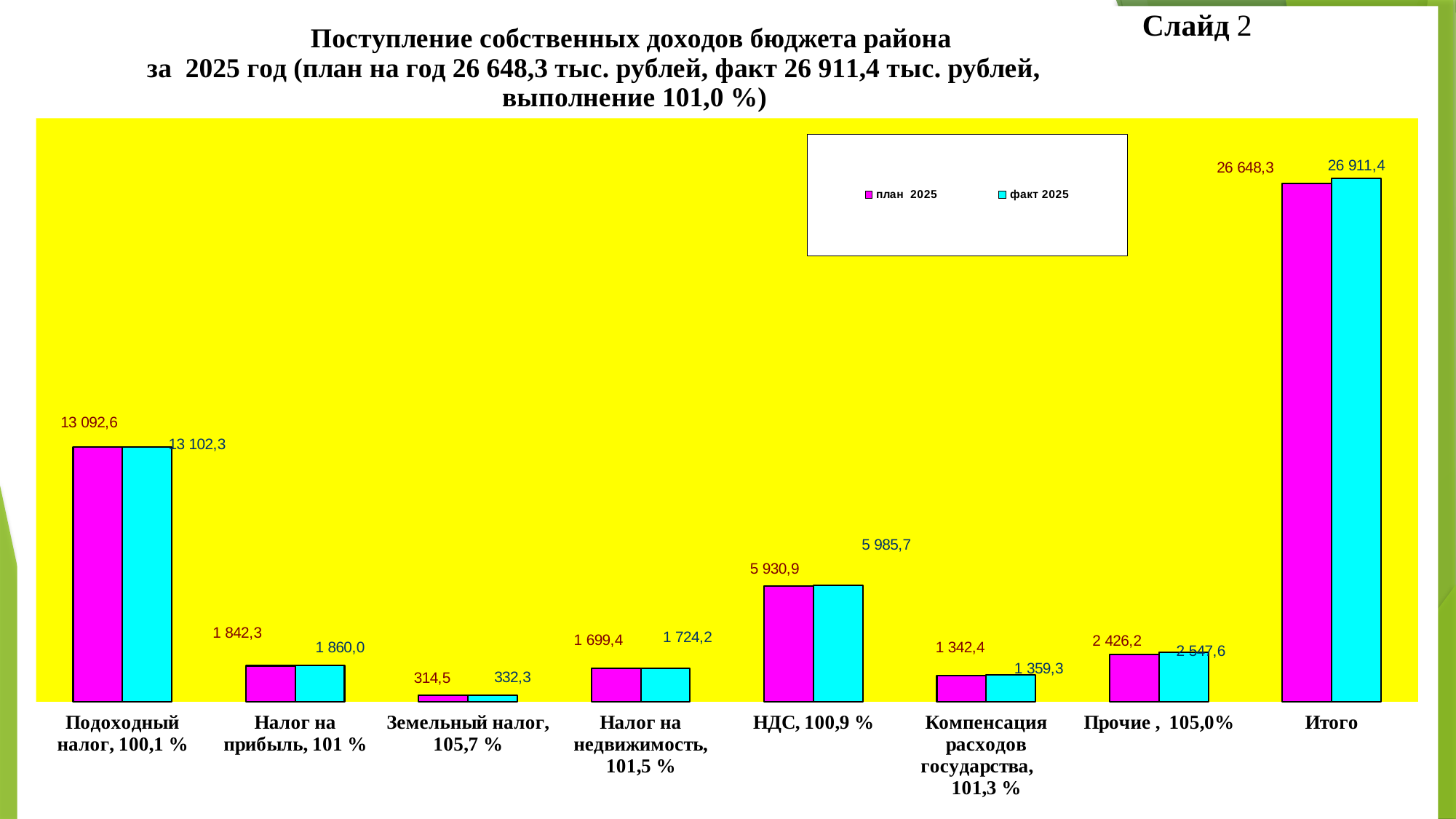
What type of chart is shown on the slide? Bar chart What is the difference between the факт 2025 and план 2025 values for Прочие? 121,4 How many categories are shown on the x axis of the chart? 8 What is the план 2025 value for Компенсация расходов государства? 1 342,4 How many series does the legend list? 2 What is the факт 2025 value for Земельный налог? 332,3 Which category has the lowest план 2025 value? Земельный налог Excluding Итого, which category has the highest факт 2025 value? Подоходный налог Which is larger for Налог на прибыль: the план 2025 value or the факт 2025 value? факт 2025 What is the difference between the факт 2025 and план 2025 values for Итого? 263,1 What is the план 2025 value for Подоходный налог? 13 092,6 What is the факт 2025 value for НДС? 5 985,7